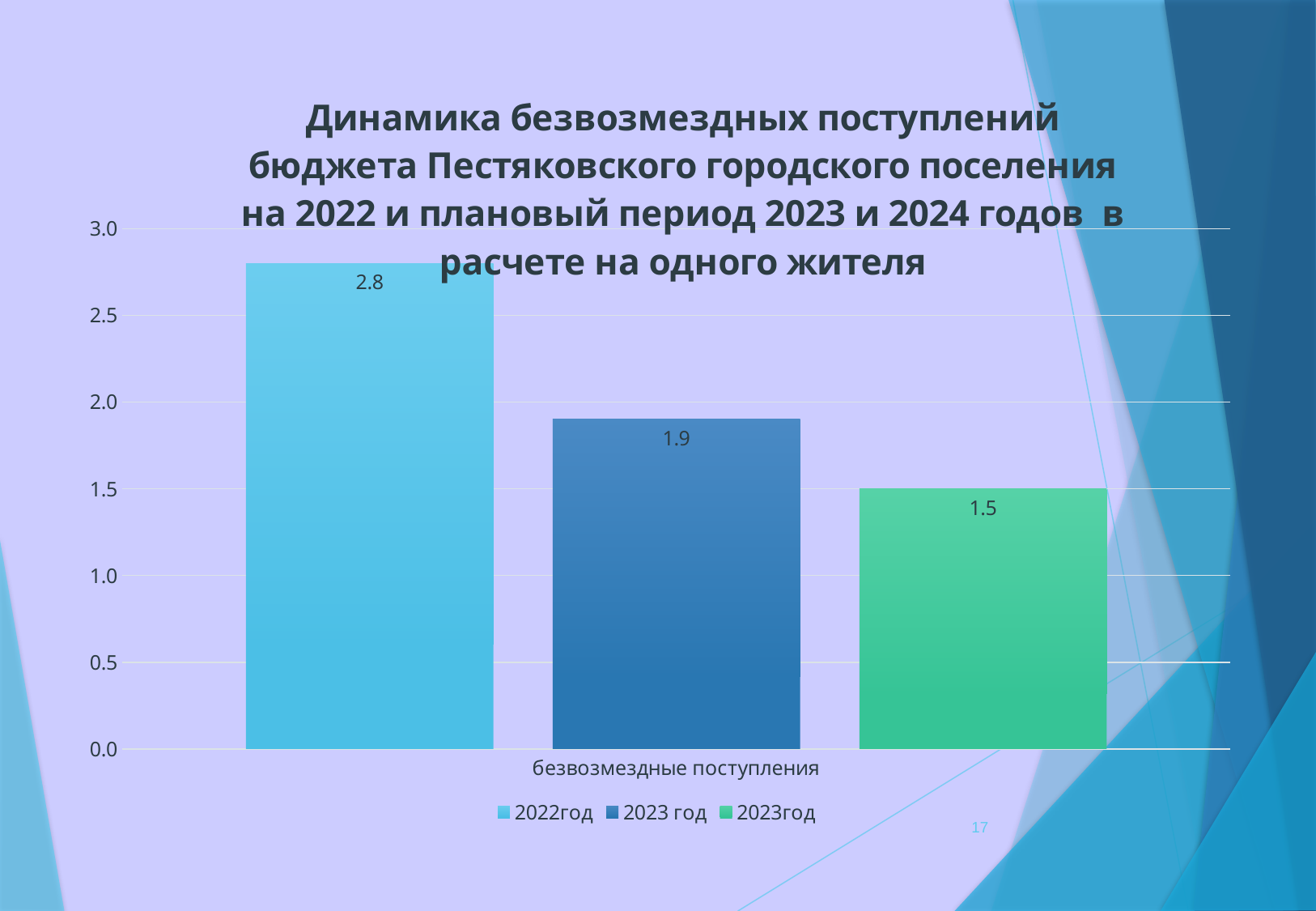
Which is larger, the middle dark blue bar or the right green bar? the middle dark blue bar How many series does the legend list? 3 What is the value of the green bar on the right? 1.5 What is the value of the light blue bar for the 2022год series? 2.8 Which series has the highest value? 2022год What type of chart is shown on the slide? bar chart What is the value of the middle (dark blue) bar? 1.9 What is the category label shown on the x axis? безвозмездные поступления Do the bar values rise or fall from left to right? fall What is the difference between the left bar (2.8) and the middle bar (1.9)? 0.9 Which bar has the lowest value? the green bar on the right (2023год) What is the difference between the 2022год bar and the green bar on the right? 1.3